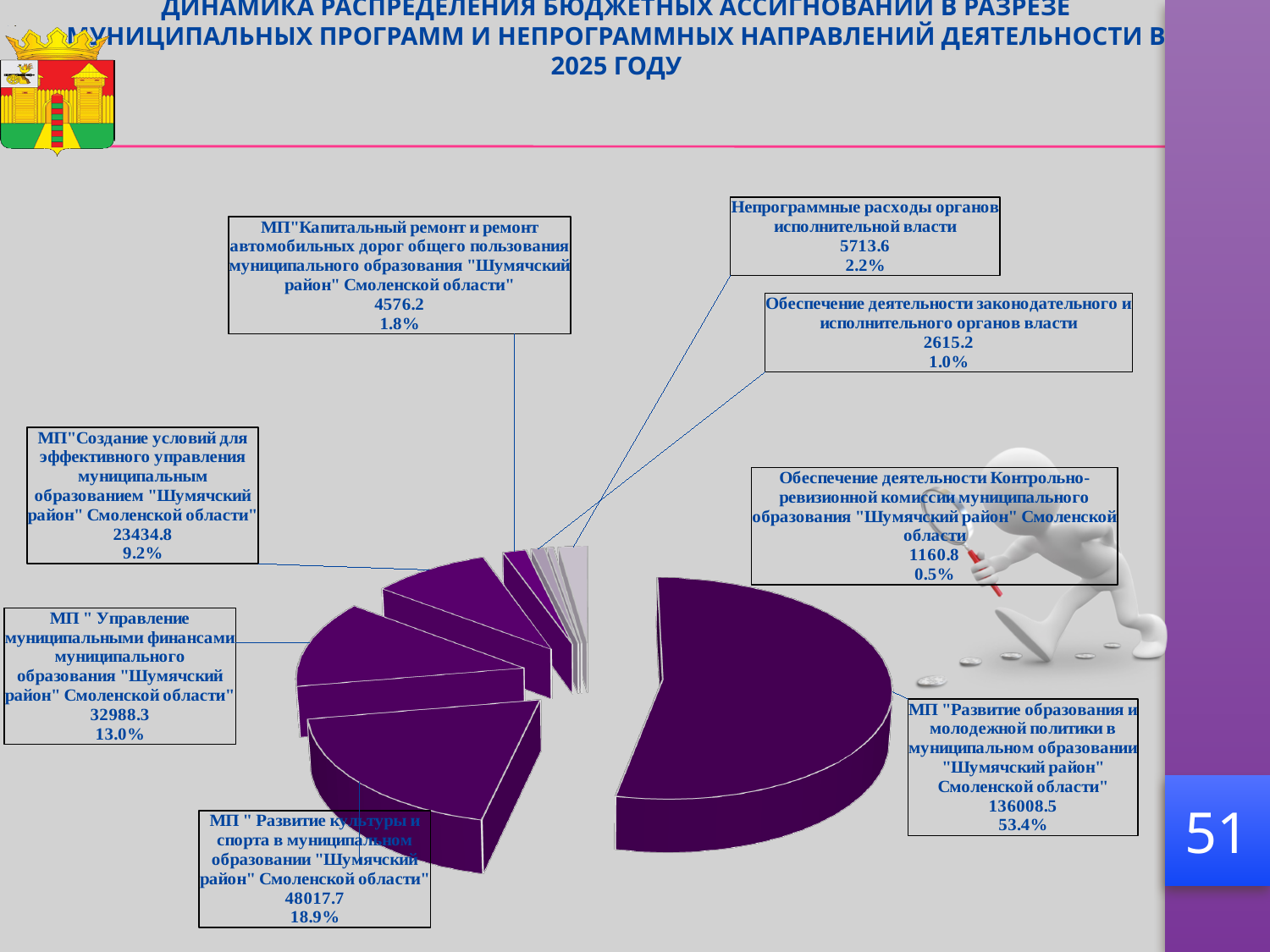
How many slices does the pie chart have? 8 What is the value shown for МП "Развитие образования и молодежной политики"? 136008.5 Which category has the smallest value in the pie chart? Обеспечение деятельности Контрольно-ревизионной комиссии муниципального образования "Шумячский район" Смоленской области Which category has the largest value in the pie chart? МП "Развитие образования и молодежной политики в муниципальном образовании "Шумячский район" Смоленской области" What is the difference between the values for МП "Развитие образования и молодежной политики" and МП "Развитие культуры и спорта"? 87990.8 Which is larger: the value for МП "Управление муниципальными финансами" or МП "Создание условий для эффективного управления муниципальным образованием"? МП "Управление муниципальными финансами" What kind of chart is shown on the slide? pie chart What is the difference between the values for Непрограммные расходы органов исполнительной власти and МП "Капитальный ремонт и ремонт автомобильных дорог"? 1137.4 What is the value shown for МП "Развитие культуры и спорта"? 48017.7 What share of the pie does МП "Развитие образования и молодежной политики" account for? 53.4% What is the value shown for Непрограммные расходы органов исполнительной власти? 5713.6 What percentage is shown for МП "Управление муниципальными финансами"? 13.0%